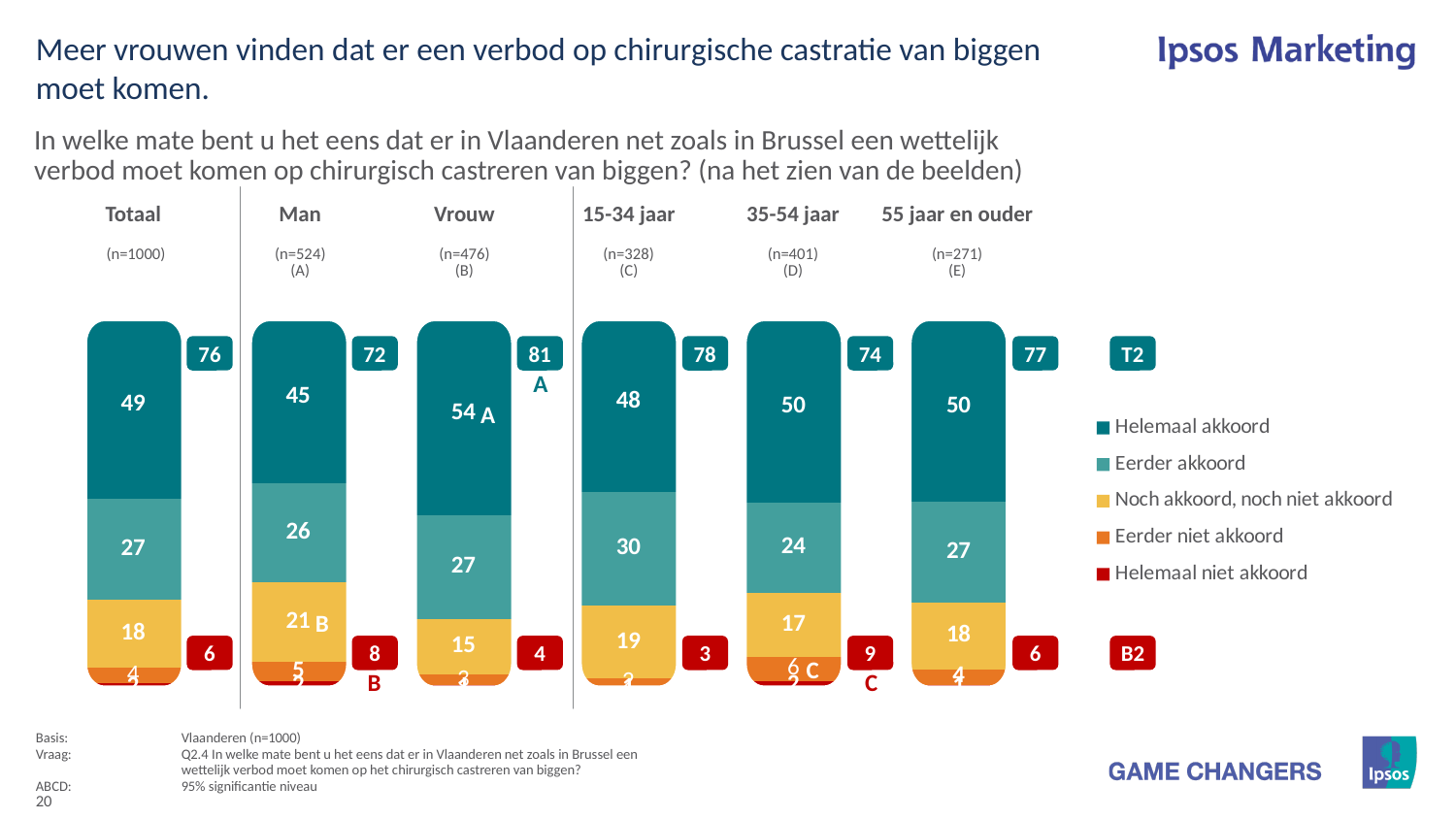
How many series does the legend list? 5 Which group has the highest T2 value? Vrouw What is the T2 (top-two) value shown for Man? 72 What is the difference between the T2 values for Vrouw and Man? 9 What is the B2 (bottom-two) value shown for the 35-54 jaar group? 9 What is the 'Helemaal akkoord' value for Vrouw? 54 What kind of chart is shown on the slide? Stacked bar chart What is the 'Eerder akkoord' value for the 15-34 jaar group? 30 What is the 'Helemaal akkoord' value for Totaal? 49 How many groups (bars) are shown in the chart? 6 Which group has the lowest B2 value? 15-34 jaar Which has a larger 'Noch akkoord, noch niet akkoord' value, Man or Vrouw? Man